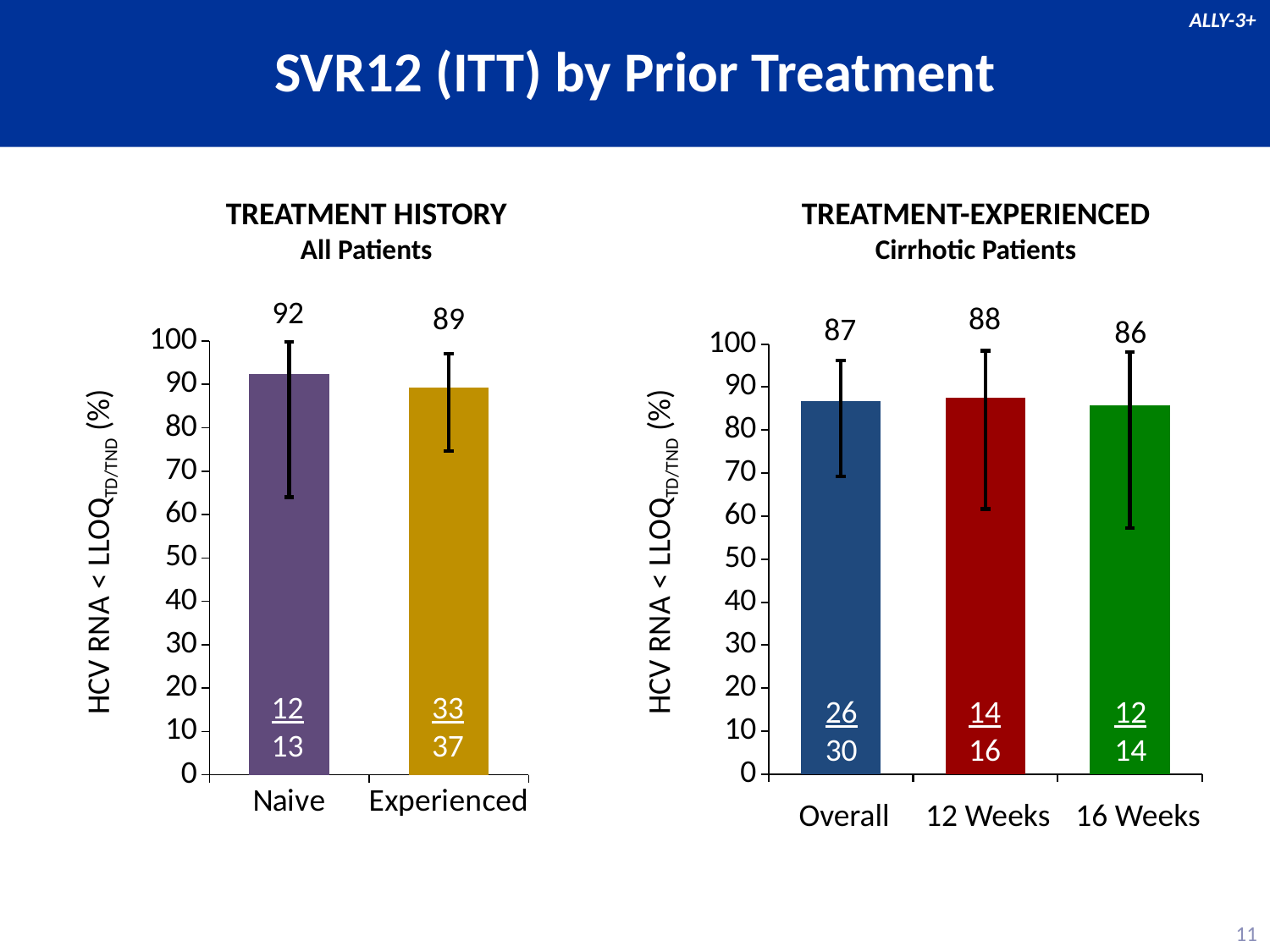
In the Treatment-Experienced Cirrhotic Patients chart, what is the difference between the 12 Weeks and 16 Weeks values? 2 How many categories are shown in the Treatment History (All Patients) chart? 2 In the Treatment-Experienced Cirrhotic Patients chart, what is the value for 12 Weeks? 88 In the Treatment-Experienced Cirrhotic Patients chart, what fraction is printed inside the Overall bar? 26/30 In the Treatment-Experienced Cirrhotic Patients chart, what is the value for 16 Weeks? 86 How many categories are shown in the Treatment-Experienced Cirrhotic Patients chart? 3 In the Treatment History (All Patients) chart, what fraction is printed inside the Experienced bar? 33/37 In the Treatment History (All Patients) chart, what is the difference between the Naive and Experienced values? 3 In the Treatment-Experienced Cirrhotic Patients chart, what is the value for Overall? 87 In the Treatment History (All Patients) chart, what is the value for Experienced? 89 In the Treatment History (All Patients) chart, what is the value for Naive? 92 What kind of chart is the Treatment History (All Patients) chart? Bar chart